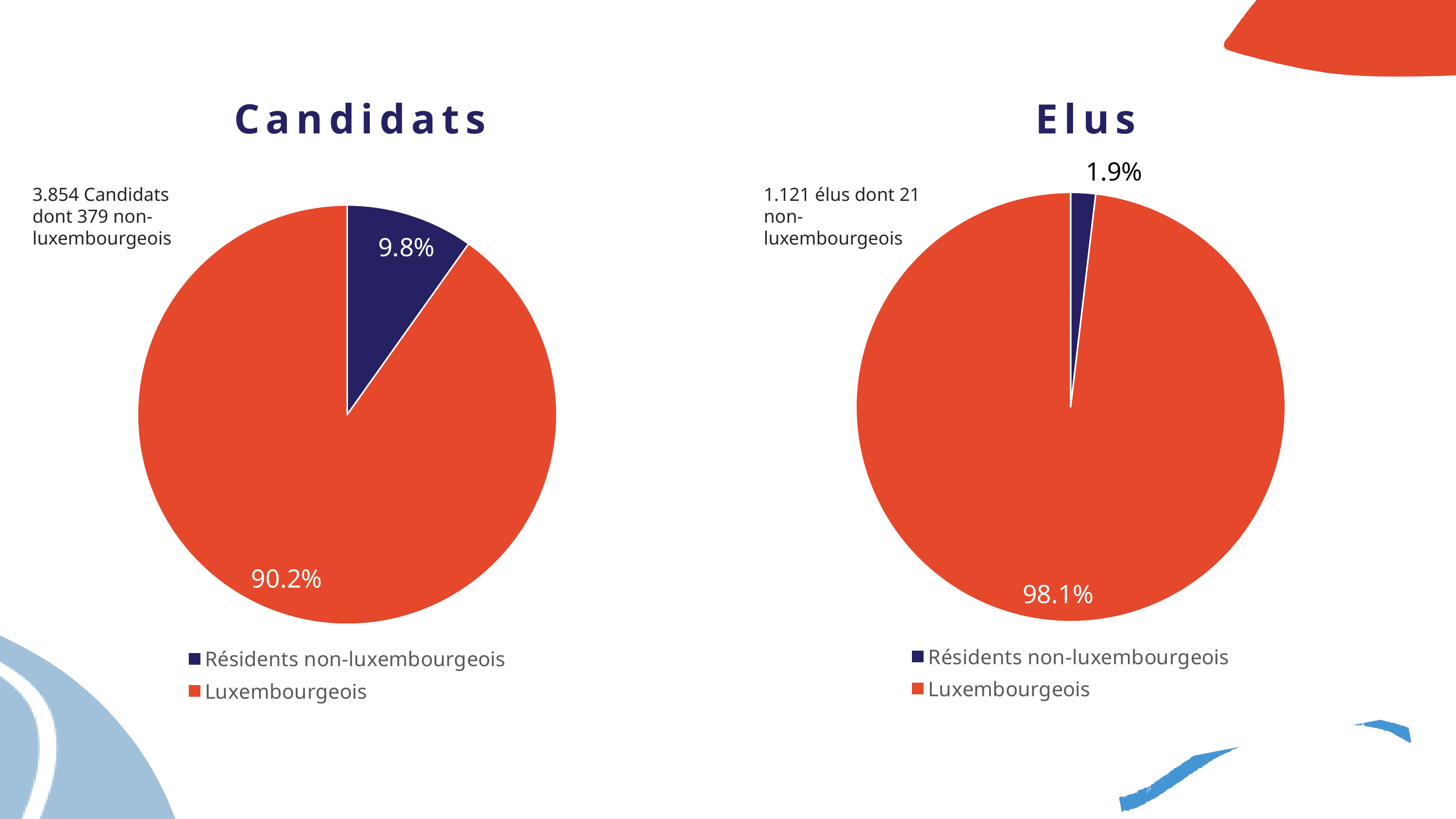
In the 'Elus' chart, which slice is the largest? Luxembourgeois In the 'Elus' chart, what share of the pie is 'Luxembourgeois'? 98.1% What colour is the 'Luxembourgeois' slice in the 'Elus' chart? Orange-red What kind of chart is the 'Candidats' chart? Pie chart In the 'Candidats' chart, what share of the pie is 'Résidents non-luxembourgeois'? 9.8% What is the difference between the 'Luxembourgeois' share in the 'Elus' chart and in the 'Candidats' chart? 7.9% In the 'Candidats' chart, what share of the pie is 'Luxembourgeois'? 90.2% Which is larger: the 'Résidents non-luxembourgeois' share in the 'Candidats' chart or in the 'Elus' chart? Candidats How many entries does the legend of the 'Candidats' chart list? 2 In the 'Candidats' chart, which slice is the smallest? Résidents non-luxembourgeois How many slices does the 'Elus' pie chart have? 2